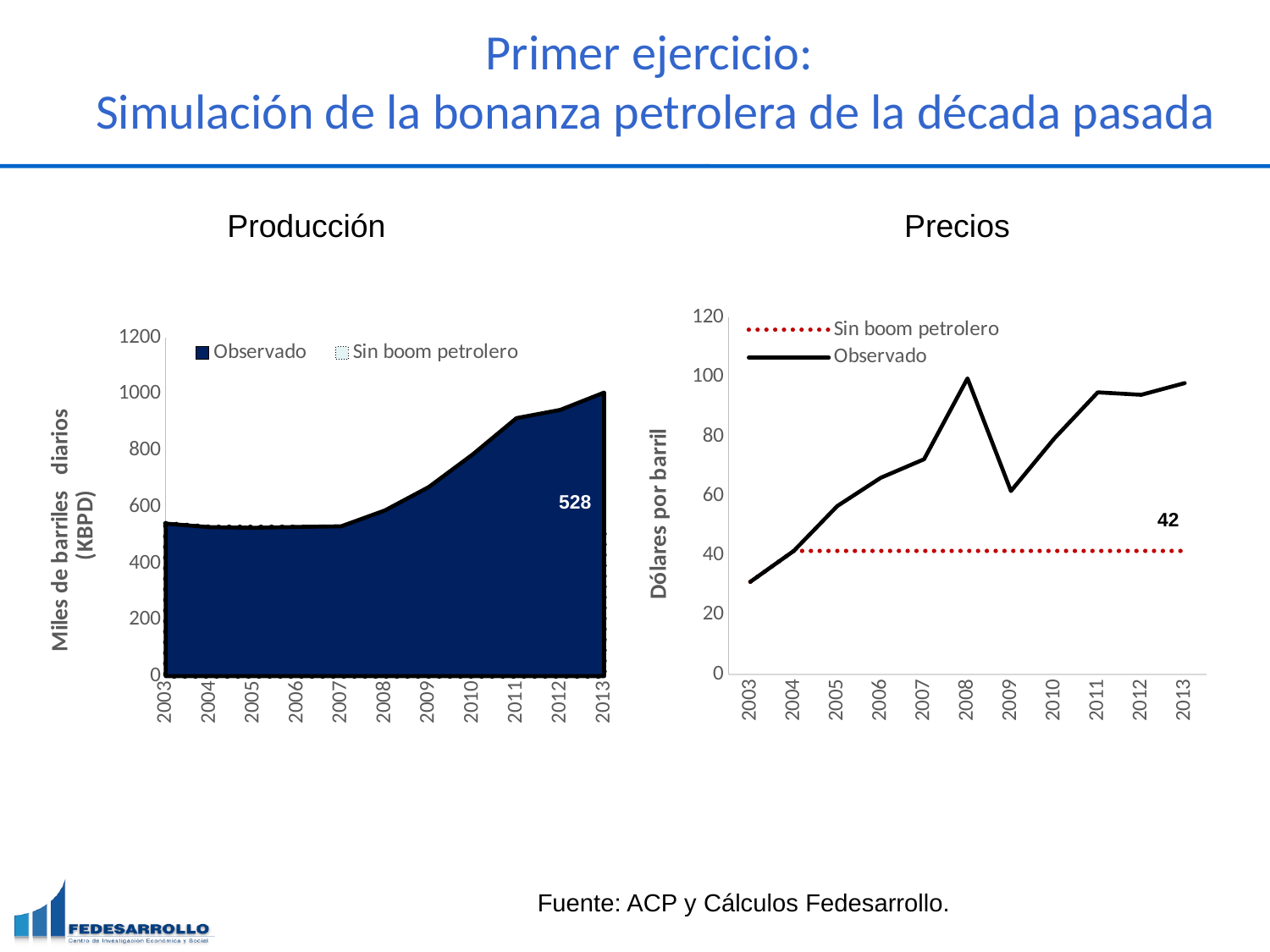
In the Producción chart, what value is labelled for the Sin boom petrolero series in 2013? 528 In the Producción chart, is the Observado value for 2013 greater or less than 800? greater In the Precios chart, which is larger for the Observado series: 2008 or 2009? 2008 In the Precios chart, which year has the lowest Observado value? 2003 In the Producción chart, does the Observado series rise or fall from 2007 to 2013? Rise In the Precios chart, what value is labelled for the Sin boom petrolero series in 2013? 42 What kind of chart is the Precios chart? Line chart How many series does the legend of the Producción chart list? 2 How many years are shown on the x axis of the Precios chart? 11 What kind of chart is the Producción chart? Area chart In the Precios chart, is the Observado value for 2008 greater or less than 80? greater In the Precios chart, is the Observado value for 2003 greater or less than 40? less